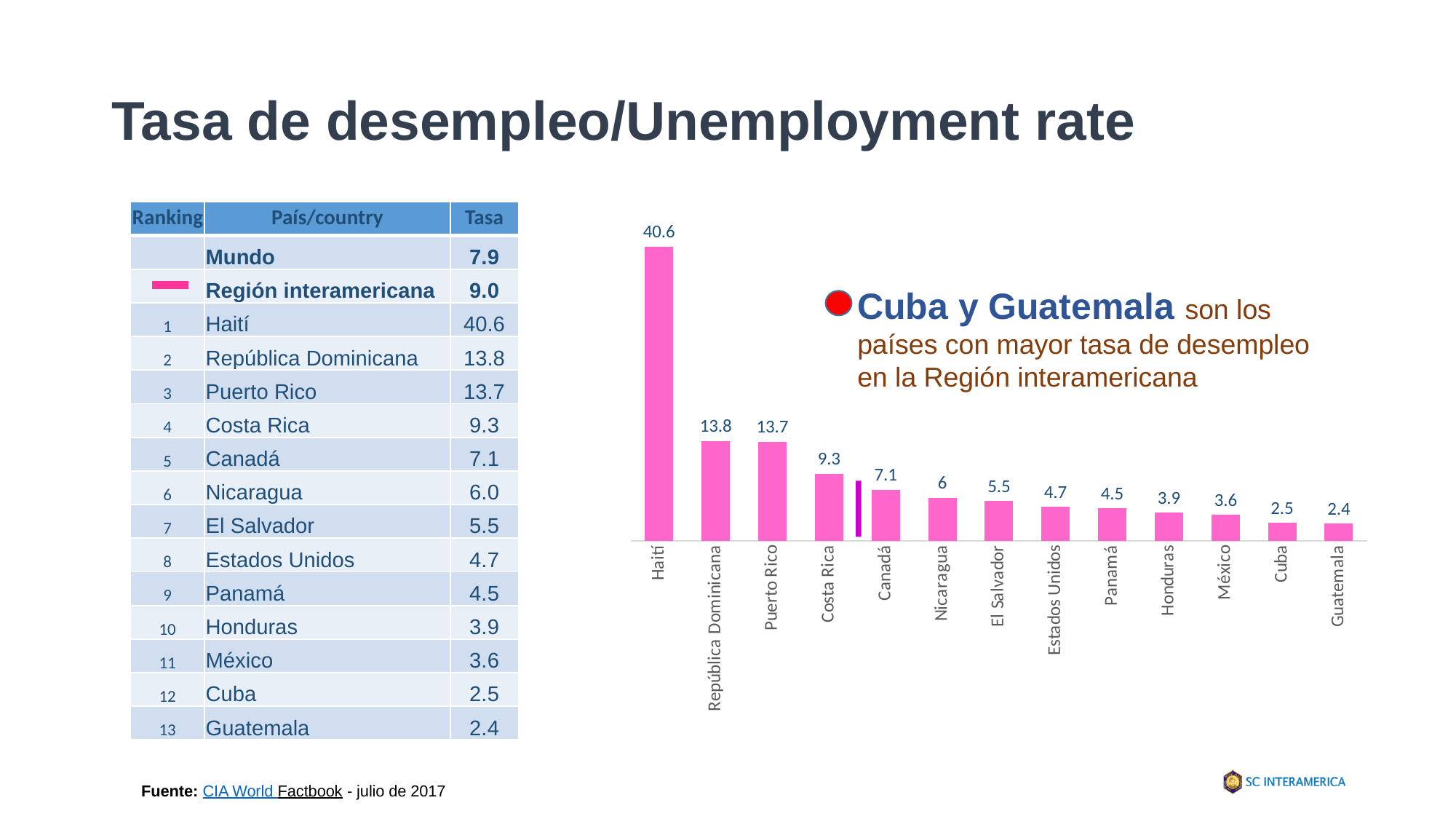
What is the value shown for Costa Rica in the chart? 9.3 What is the unemployment rate shown for Haití in the chart? 40.6 Which has a larger value in the chart, El Salvador or Estados Unidos? El Salvador Which has a larger value in the chart, México or Panamá? Panamá What is the value shown for Honduras in the chart? 3.9 Do the bar values rise or fall from left to right along the x axis of the chart? fall Which country has the highest bar in the chart? Haití What type of chart is shown on the slide? bar chart Which country has the lowest bar in the chart? Guatemala How many countries are shown as labeled categories along the x axis of the chart? 13 What is the difference between the values for República Dominicana and Puerto Rico in the chart? 0.1 What is the difference between the values for Haití and Canadá in the chart? 33.5